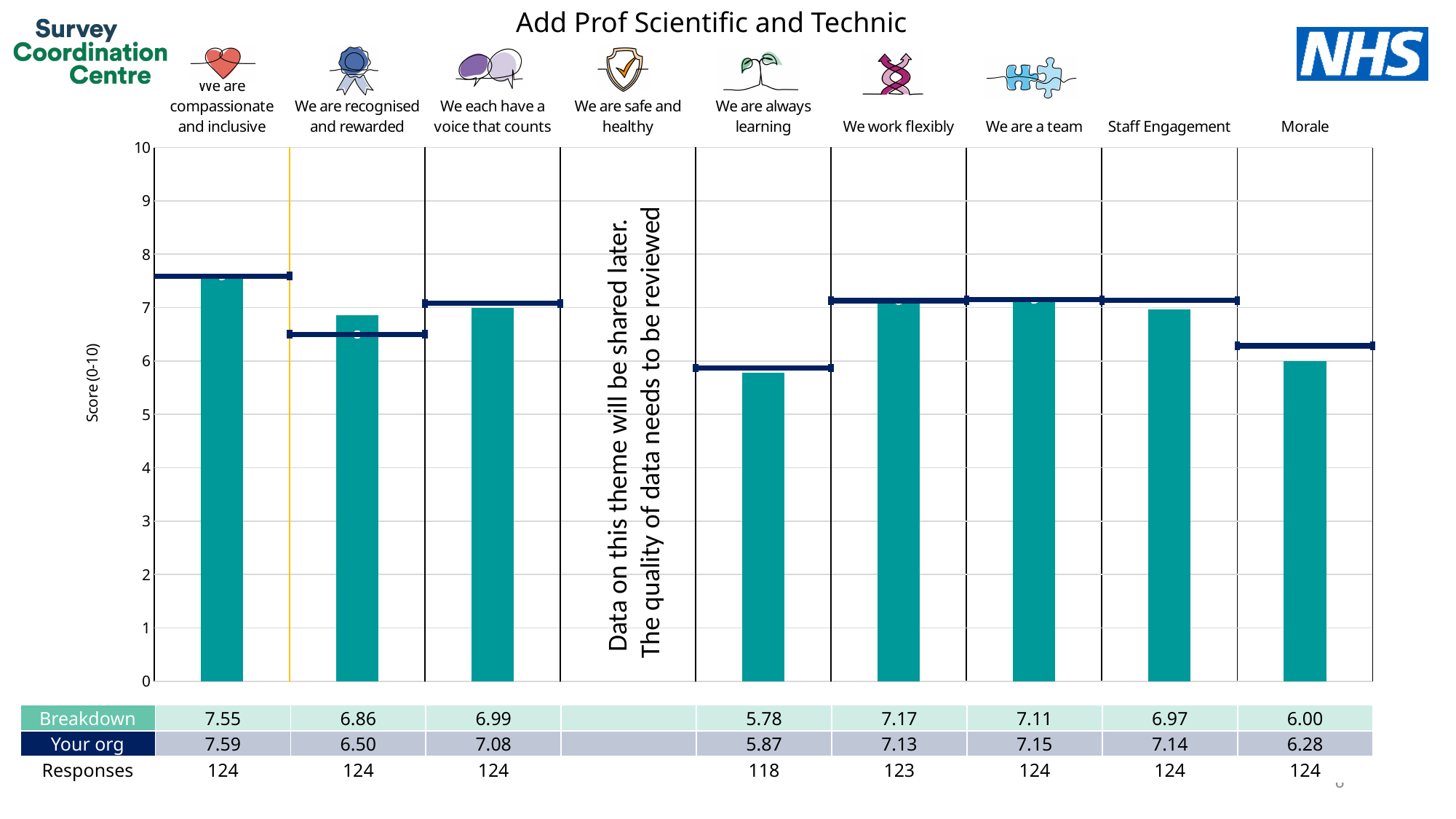
How many responses are recorded for 'We are always learning'? 118 What is the Your org score for Morale? 6.28 Is the Breakdown score for Morale greater or less than 7? less Which is larger for 'We work flexibly': the Breakdown score or the Your org score? Breakdown Which theme has the lowest Breakdown score? We are always learning What is the title of the chart? Add Prof Scientific and Technic What is the Breakdown score for 'We are compassionate and inclusive'? 7.55 What is the Your org score for 'We are recognised and rewarded'? 6.50 What is the difference between the Breakdown and Your org scores for 'We are recognised and rewarded'? 0.36 What type of chart is shown on the slide? bar chart What is the Breakdown score for 'We are always learning'? 5.78 Which theme has the highest Breakdown score? We are compassionate and inclusive